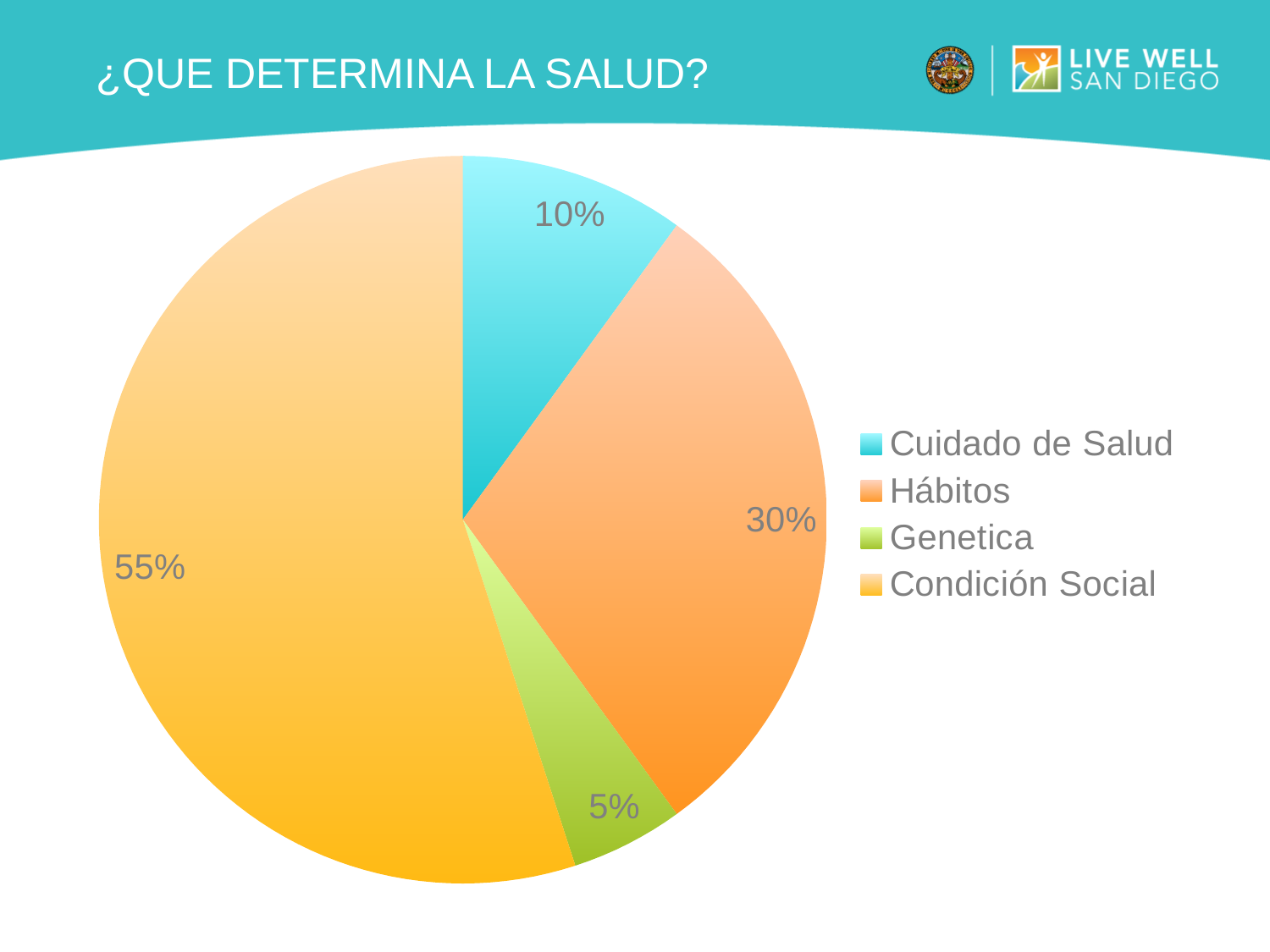
What is the difference between the values for Cuidado de Salud and Genetica? 5% Which category has the smallest slice of the pie? Genetica What is the value shown for Hábitos? 30% What kind of chart is shown on the slide? pie chart What is the value shown for Genetica? 5% What is the value shown for Cuidado de Salud? 10% What colour is the slice for Genetica? green What is the difference between the values for Condición Social and Hábitos? 25% What share of the pie does Condición Social represent? 55% Which is larger, Hábitos or Cuidado de Salud? Hábitos How many categories does the pie chart have? 4 Which category has the largest slice of the pie? Condición Social